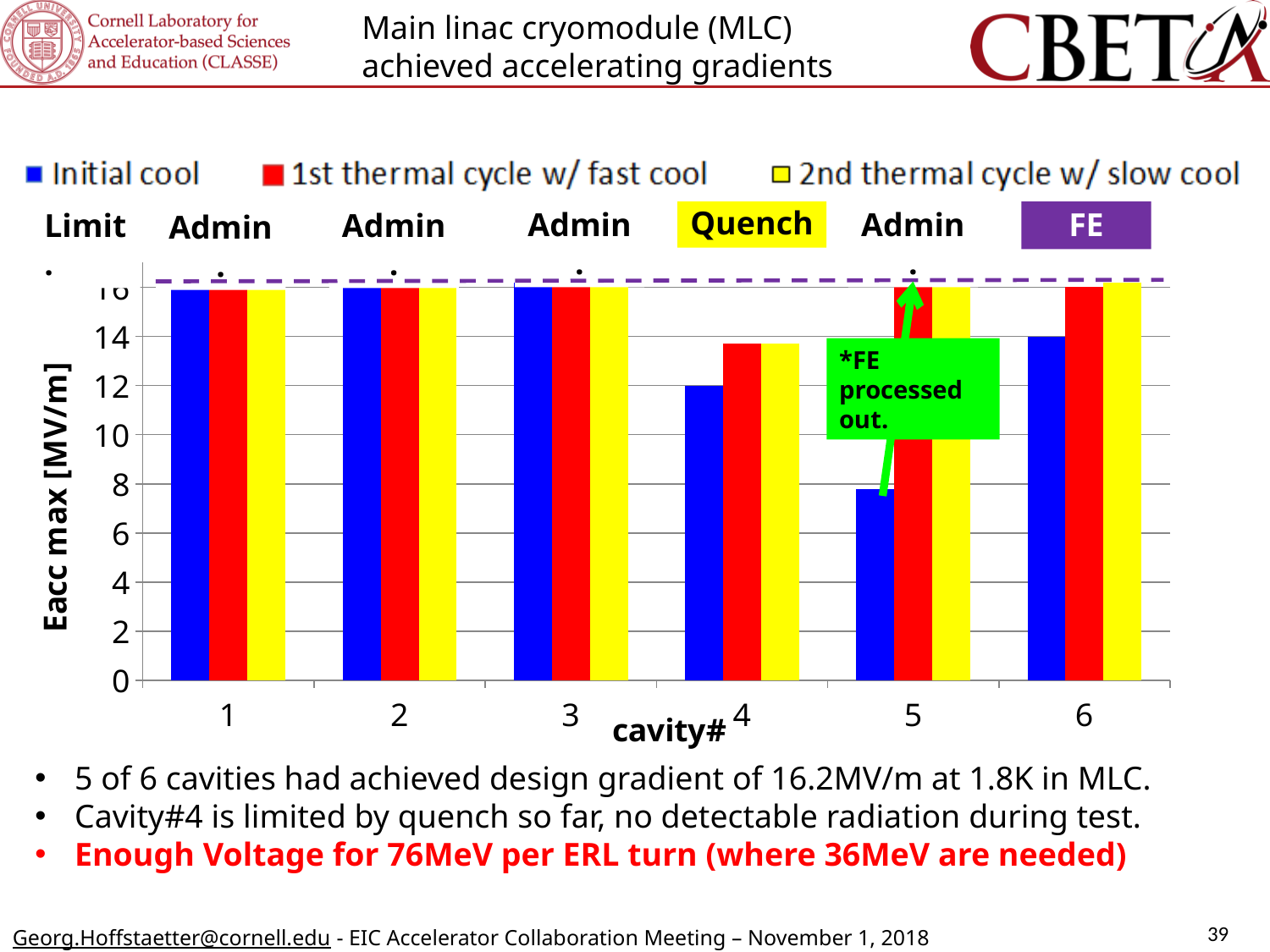
Is the Initial cool value for cavity 1 greater or less than 14? greater What is the label on the y axis? Eacc max [MV/m] How many series does the legend list? 3 Which cavity has the lowest Initial cool value? 5 What is the label on the x axis? cavity# Is the Initial cool value for cavity 5 greater or less than 10? less Which is larger for cavity 5, the Initial cool value or the 1st thermal cycle w/ fast cool value? 1st thermal cycle w/ fast cool How many cavities are plotted along the x axis? 6 Which is larger, the Initial cool value for cavity 4 or for cavity 6? cavity 6 Is the 1st thermal cycle w/ fast cool value for cavity 4 greater or less than 12? greater What kind of chart is shown on the slide? bar chart